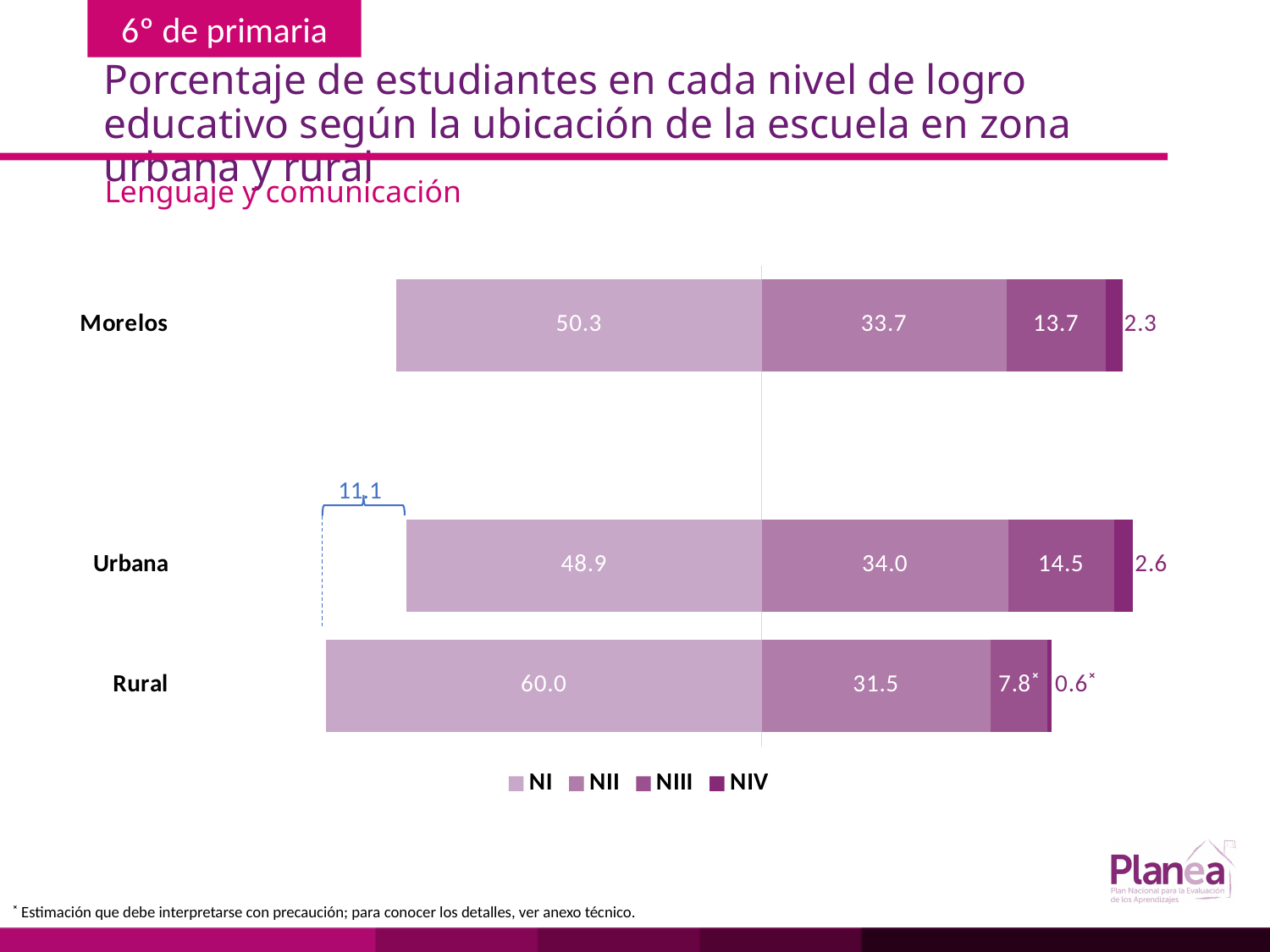
What is the NII value for Morelos? 33.7 What is the NIII value for Urbana? 14.5 What is the difference between the NI values for Rural and Urbana? 11.1 Which category has the lowest NIII value? Rural How many categories are shown on the chart? 3 Which is larger, the NII value for Urbana or the NII value for Rural? Urbana Which category has the highest NI value? Rural How many series does the legend list? 4 What is the NI value for Rural? 60.0 What is the NIV value for Rural? 0.6 What kind of chart is shown on the slide? Stacked bar chart What is the subtitle shown above the chart? Lenguaje y comunicación